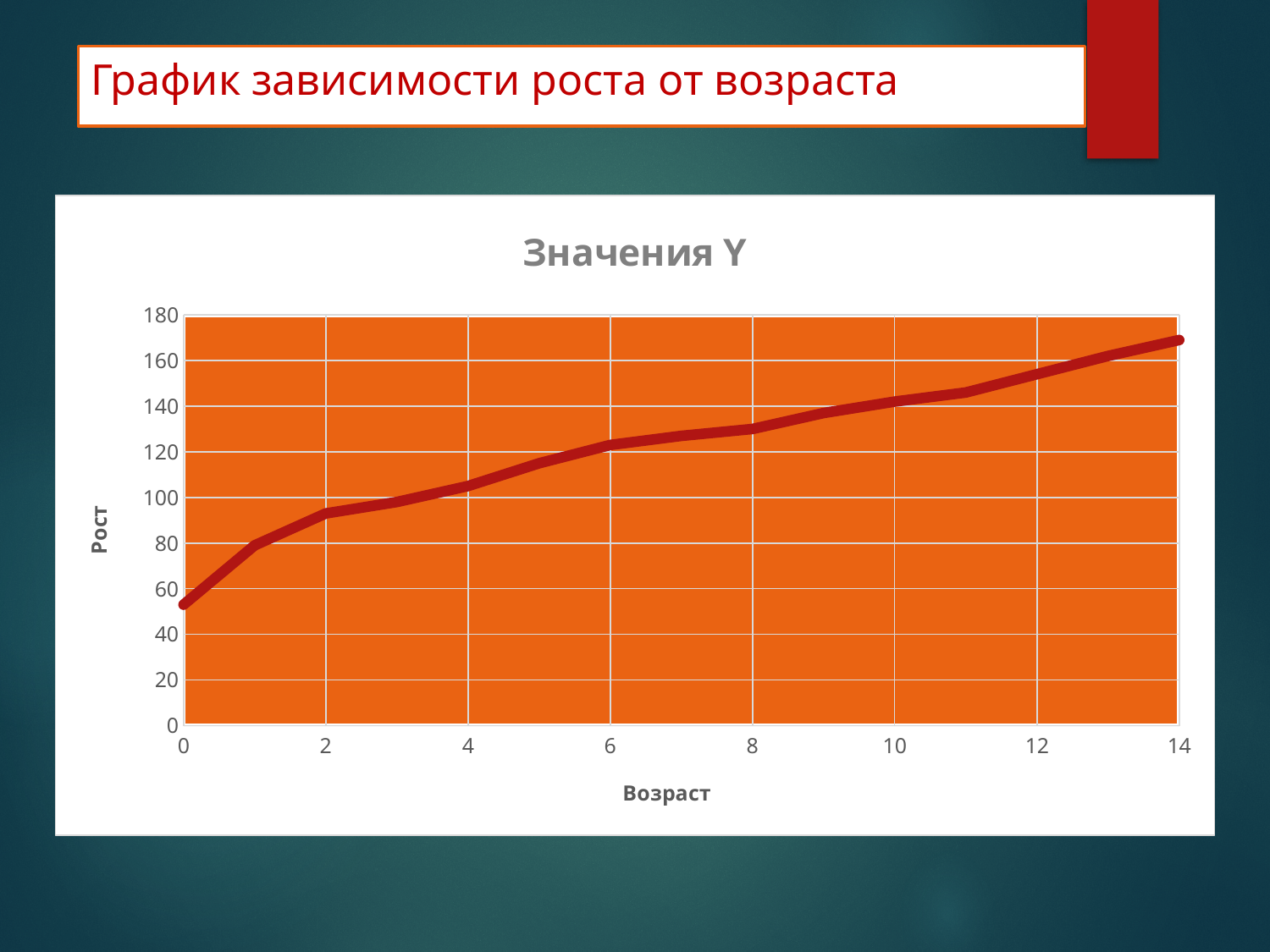
Is the value for Возраст 14 greater or less than 160? greater At which Возраст value is Рост lowest? 0 Is the value for Возраст 8 greater or less than 120? greater Is the value for Возраст 2 greater or less than 80? greater Do the values rise or fall as Возраст increases along the x axis? rise What is the title of the chart? Значения Y Which is larger, the value at Возраст 14 or the value at Возраст 0? Возраст 14 What kind of chart is shown on the slide? line chart What is the label of the vertical axis? Рост At which Возраст value is Рост highest? 14